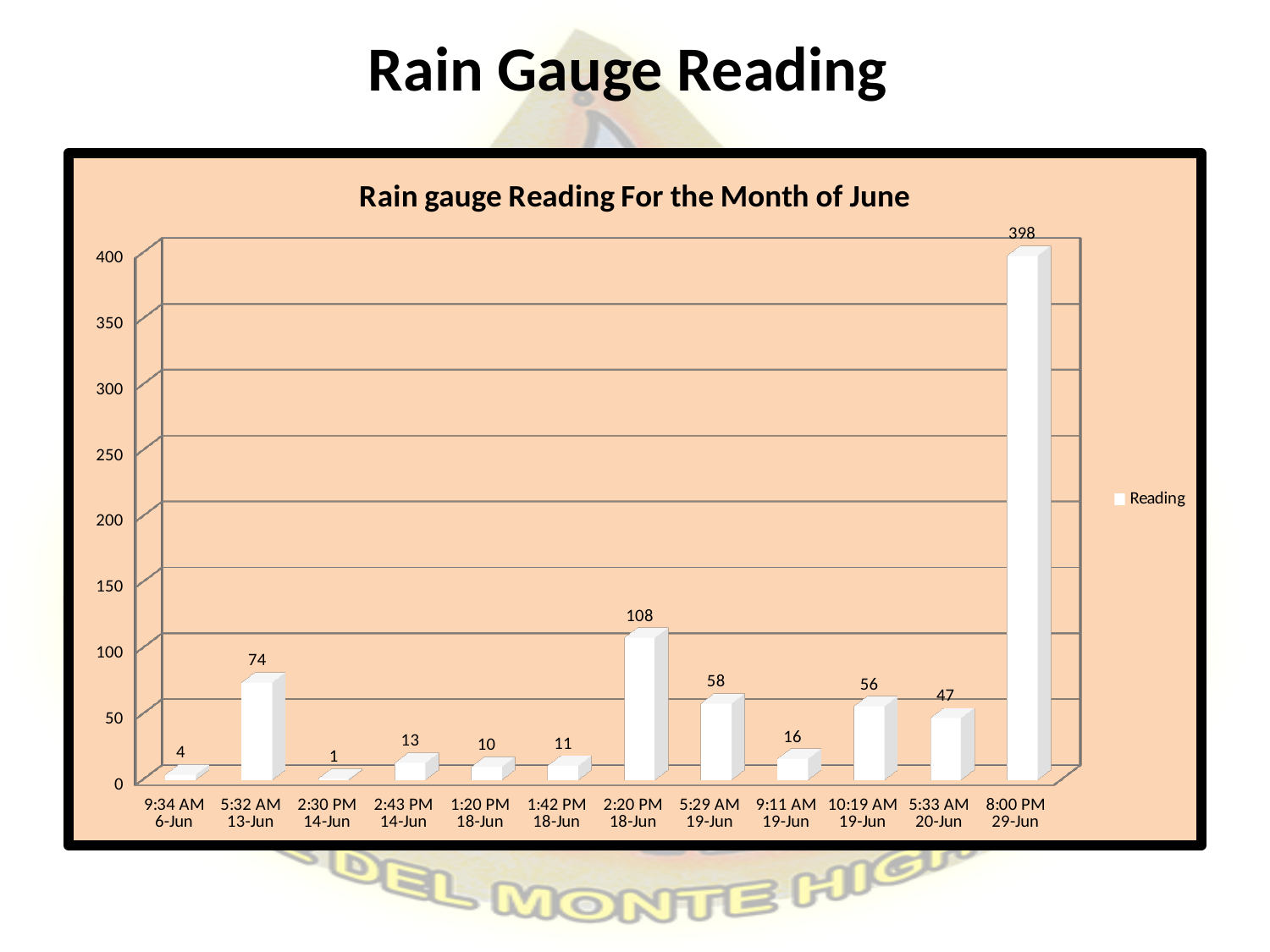
Which date and time has the highest reading? 8:00 PM 29-Jun What is the difference between the readings for 5:29 AM 19-Jun and 10:19 AM 19-Jun? 2 Which is larger, the reading for 5:32 AM 13-Jun or the reading for 5:33 AM 20-Jun? 5:32 AM 13-Jun How many series does the legend list? 1 What is the difference between the readings for 8:00 PM 29-Jun and 2:20 PM 18-Jun? 290 What kind of chart is shown? Bar chart What is the reading for 2:20 PM 18-Jun? 108 What is the reading for 8:00 PM 29-Jun? 398 Which date and time has the lowest reading? 2:30 PM 14-Jun How many readings are plotted on the chart? 12 What is the reading for 5:32 AM 13-Jun? 74 Is the reading for 2:20 PM 18-Jun greater or less than 100? greater